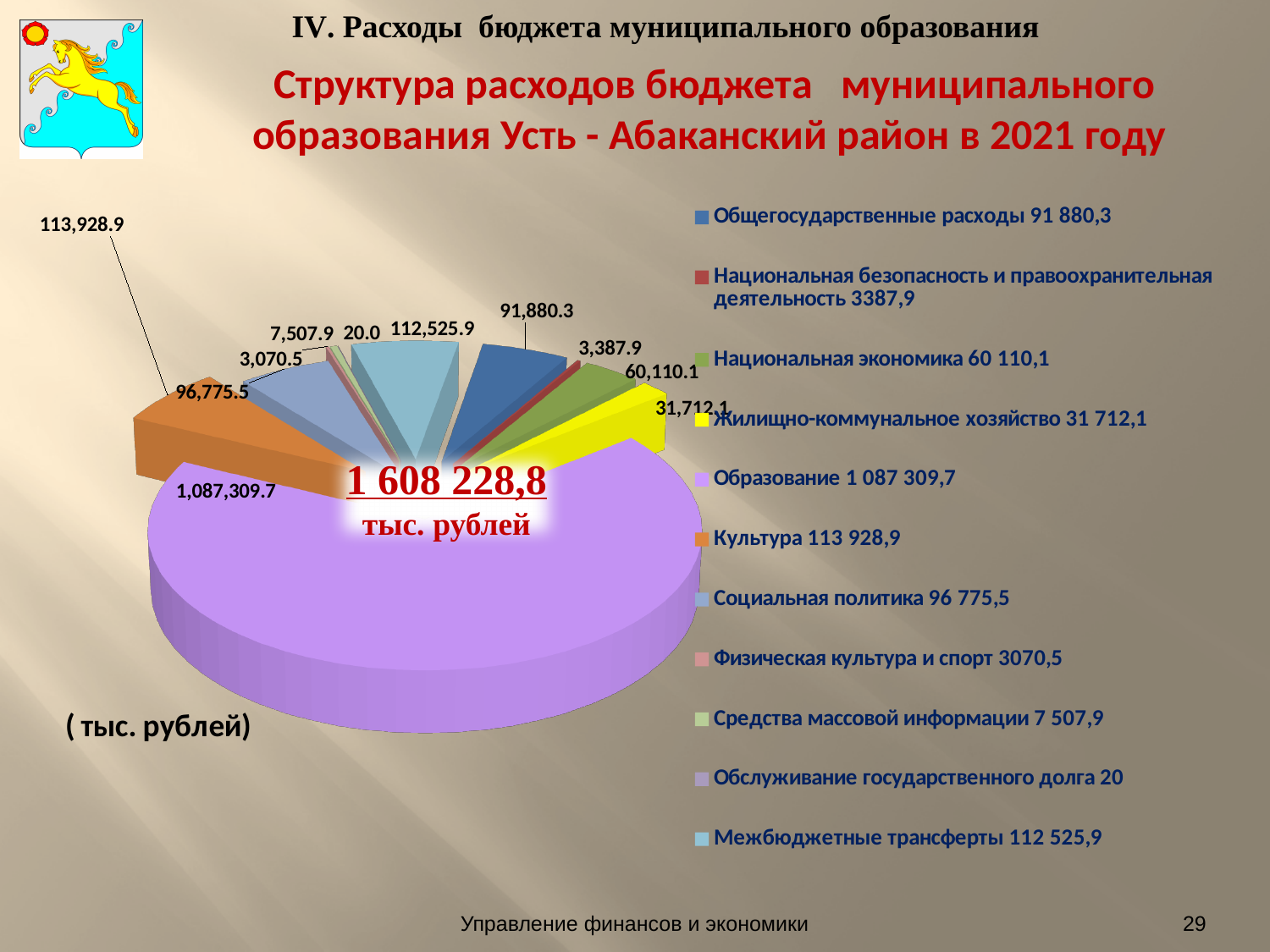
What type of chart is shown on the slide? pie chart How many categories does the pie chart legend list? 11 What is the difference between the values for Национальная экономика and Жилищно-коммунальное хозяйство? 28,398.0 What is the value for Культура on the pie chart? 113,928.9 What is the value for Межбюджетные трансферты on the pie chart? 112,525.9 What is the value for Обслуживание государственного долга on the pie chart? 20.0 Which category has the largest slice of the pie chart? Образование Which category has the smallest value on the pie chart? Обслуживание государственного долга What is the difference between the values for Культура and Межбюджетные трансферты? 1,403.0 What is the value for Образование on the pie chart? 1,087,309.7 Which is larger: Социальная политика or Общегосударственные расходы? Социальная политика What total value is printed in the centre of the pie chart? 1 608 228,8 тыс. рублей